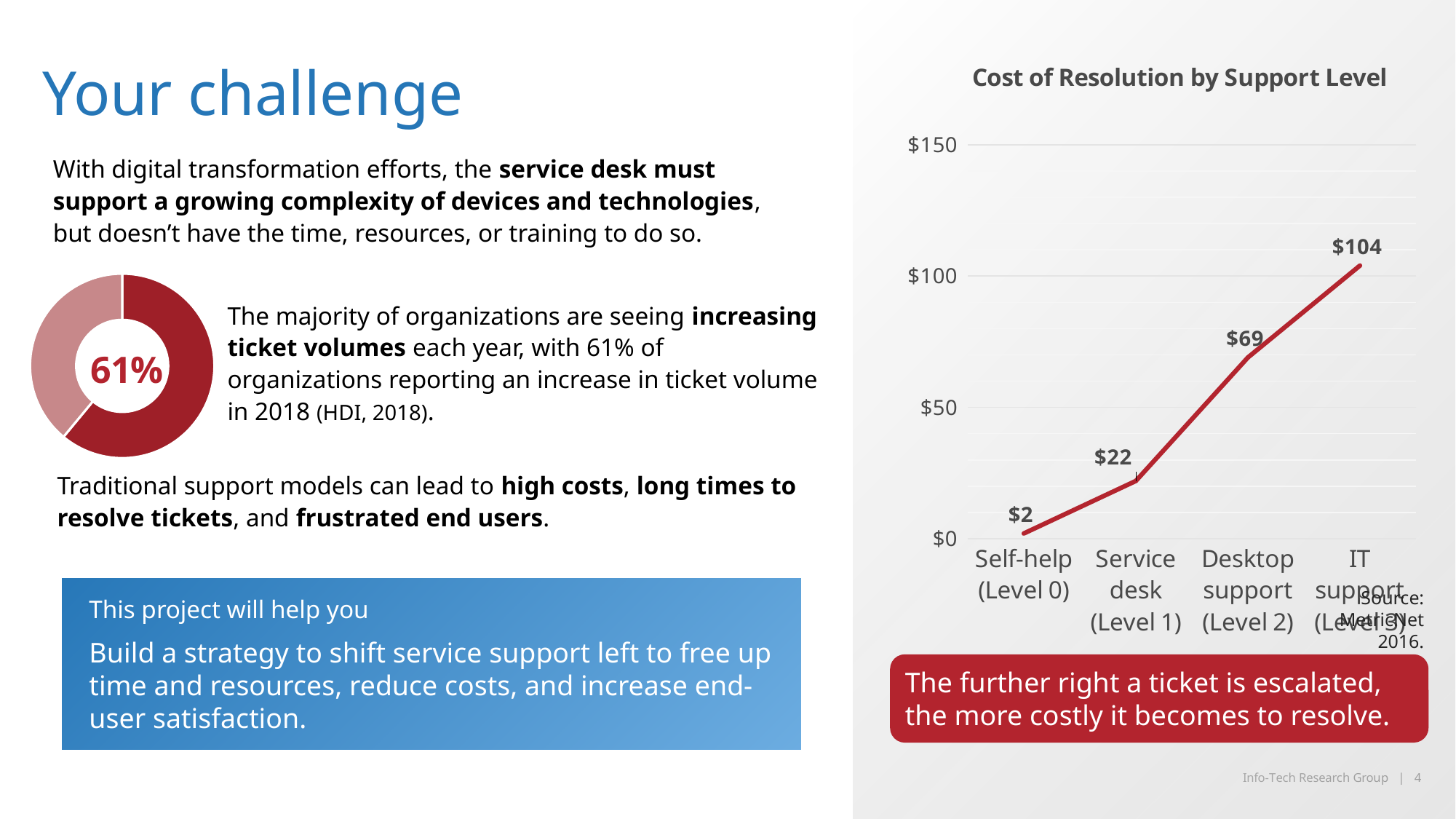
What kind of chart is the 'Cost of Resolution by Support Level' chart? Line chart In the 'Cost of Resolution by Support Level' chart, what is the difference in cost between IT support (Level 3) and Desktop support (Level 2)? $35 In the 'Cost of Resolution by Support Level' chart, what is the cost of resolution for Service desk (Level 1)? $22 In the 'Cost of Resolution by Support Level' chart, do the values rise or fall from Self-help (Level 0) to IT support (Level 3)? Rise In the 'Cost of Resolution by Support Level' chart, what is the cost of resolution for Self-help (Level 0)? $2 In the 'Cost of Resolution by Support Level' chart, is the value for IT support (Level 3) greater or less than $100? greater In the 'Cost of Resolution by Support Level' chart, what is the cost of resolution for Desktop support (Level 2)? $69 In the 'Cost of Resolution by Support Level' chart, which support level has the lowest cost of resolution? Self-help (Level 0) In the 'Cost of Resolution by Support Level' chart, which has a higher cost of resolution: Service desk (Level 1) or Desktop support (Level 2)? Desktop support (Level 2) How many support levels are plotted in the 'Cost of Resolution by Support Level' chart? 4 In the 'Cost of Resolution by Support Level' chart, which support level has the highest cost of resolution? IT support (Level 3) What percentage is shown in the centre of the donut chart on the left side of the slide? 61%